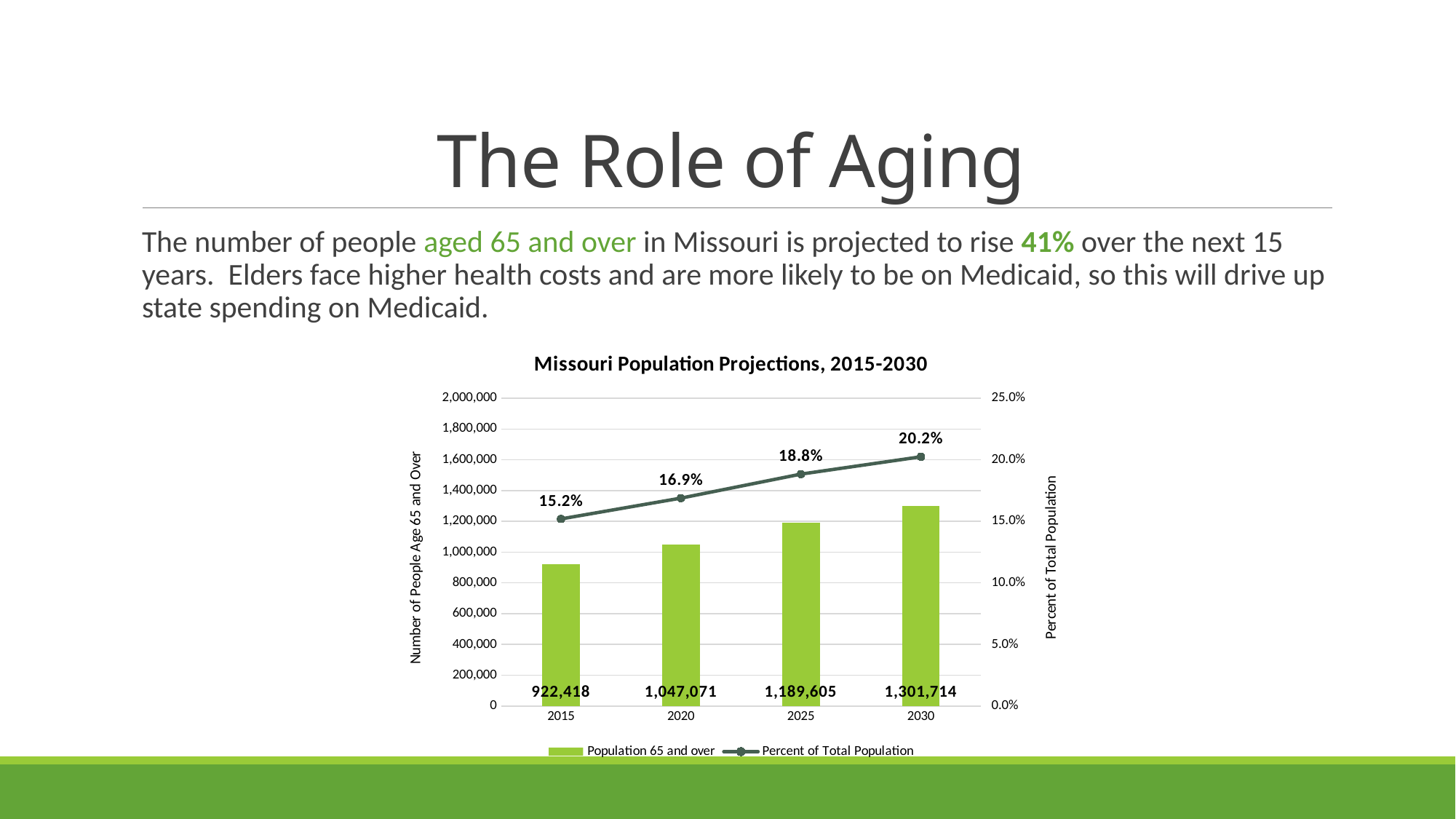
What percent of the total population is projected to be aged 65 and over in 2020? 16.9% Which year has the highest projected population aged 65 and over? 2030 Which year has the lowest percent of total population aged 65 and over? 2015 What is the difference in percent of total population between 2030 and 2015? 5.0% How many years are shown on the x axis of the chart? 4 How many series does the chart legend list? 2 Which is larger, the population aged 65 and over in 2020 or in 2025? 2025 What is the difference between the projected population aged 65 and over in 2030 and in 2015? 379,296 Does the percent of total population aged 65 and over rise or fall from 2015 to 2030? rise What is the projected population aged 65 and over in Missouri in 2030? 1,301,714 What is the projected population aged 65 and over in Missouri in 2015? 922,418 What percent of the total population is projected to be aged 65 and over in 2025? 18.8%